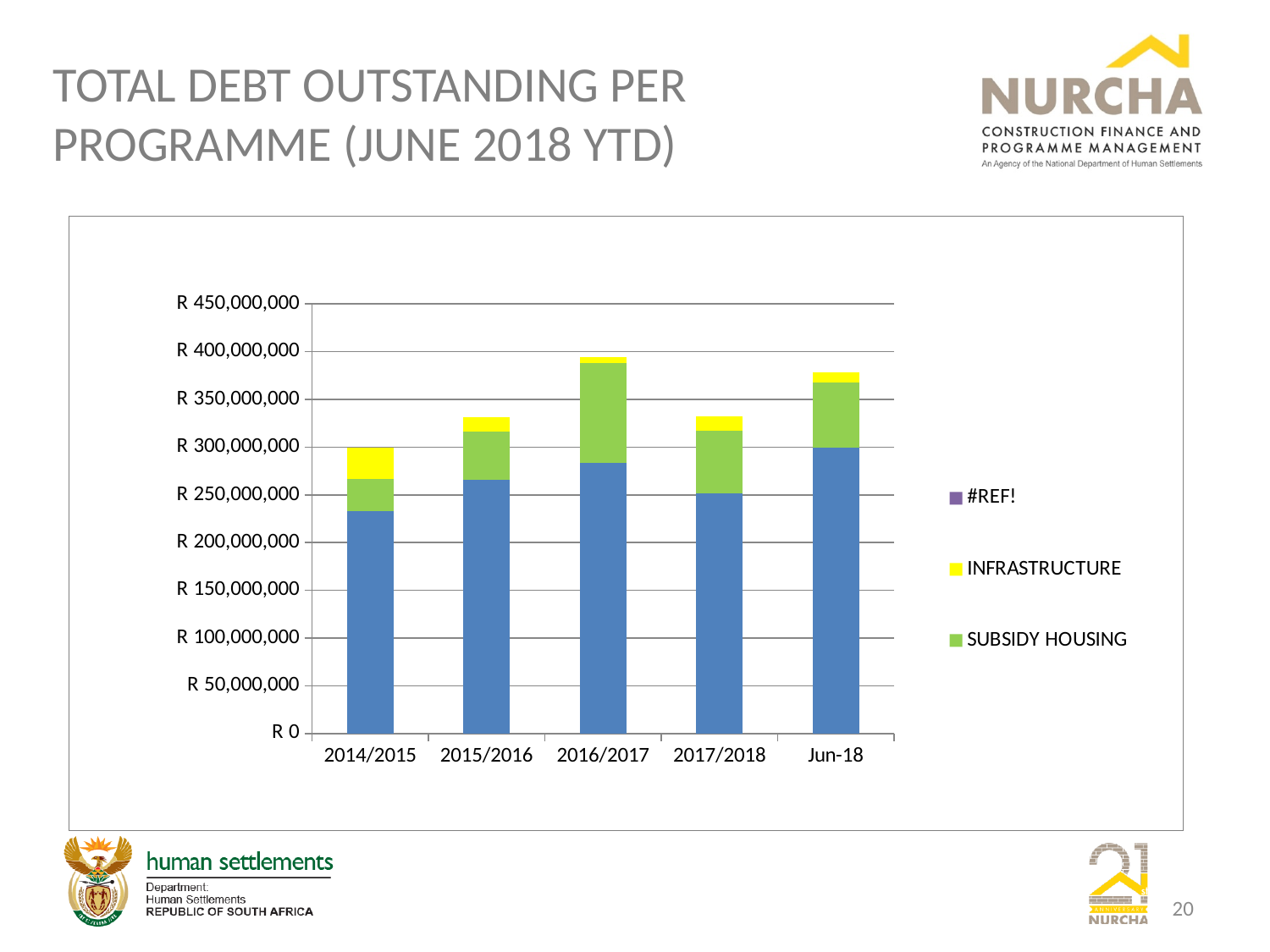
Is the total stacked bar for 2014/2015 greater or less than R 350,000,000? less Which has the larger total stacked bar, 2016/2017 or 2017/2018? 2016/2017 How many categories are shown on the x axis of the chart? 5 Which has the larger total stacked bar, Jun-18 or 2015/2016? Jun-18 How many series does the chart legend list? 3 Is the total stacked bar for 2016/2017 greater or less than R 350,000,000? greater Is the total stacked bar for 2015/2016 greater or less than R 300,000,000? greater Which category has the tallest stacked bar (highest total debt outstanding)? 2016/2017 Which legend entry is shown in yellow? INFRASTRUCTURE What kind of chart is shown on the slide? Stacked bar chart Which category has the shortest stacked bar (lowest total debt outstanding)? 2014/2015